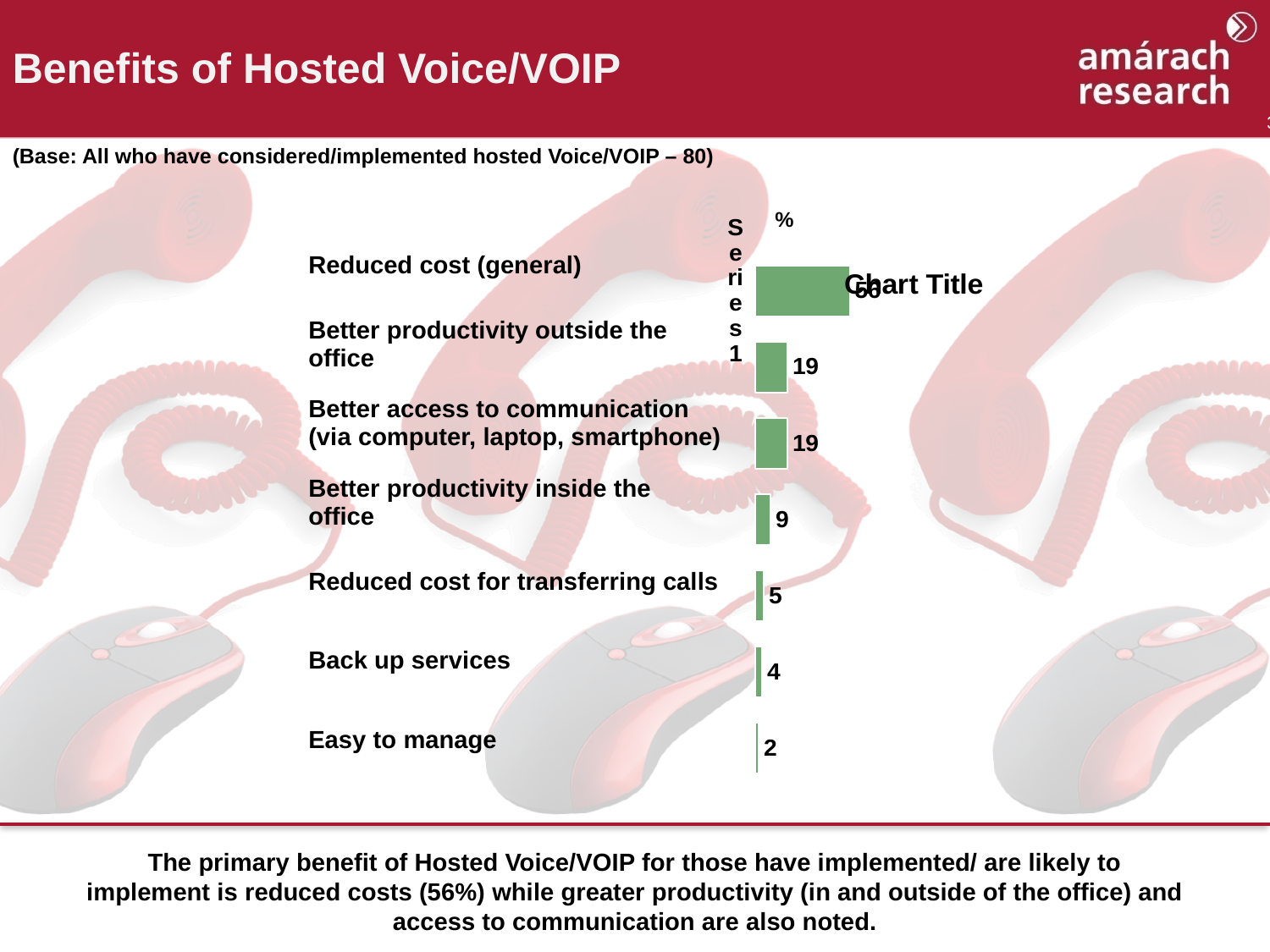
Which category has the highest value? Reduced cost (general) What is the value for "Back up services"? 4 What kind of chart is shown on the slide? bar chart What is the value for "Reduced cost (general)"? 56 Which is larger, the value for "Back up services" or the value for "Reduced cost for transferring calls"? Reduced cost for transferring calls How many categories are shown in the chart? 7 What is the value for "Reduced cost for transferring calls"? 5 What is the value for "Better productivity inside the office"? 9 What is the difference between the values for "Better productivity outside the office" and "Better productivity inside the office"? 10 What is the value for "Better productivity outside the office"? 19 Which category has the lowest value? Easy to manage What is the value for "Easy to manage"? 2